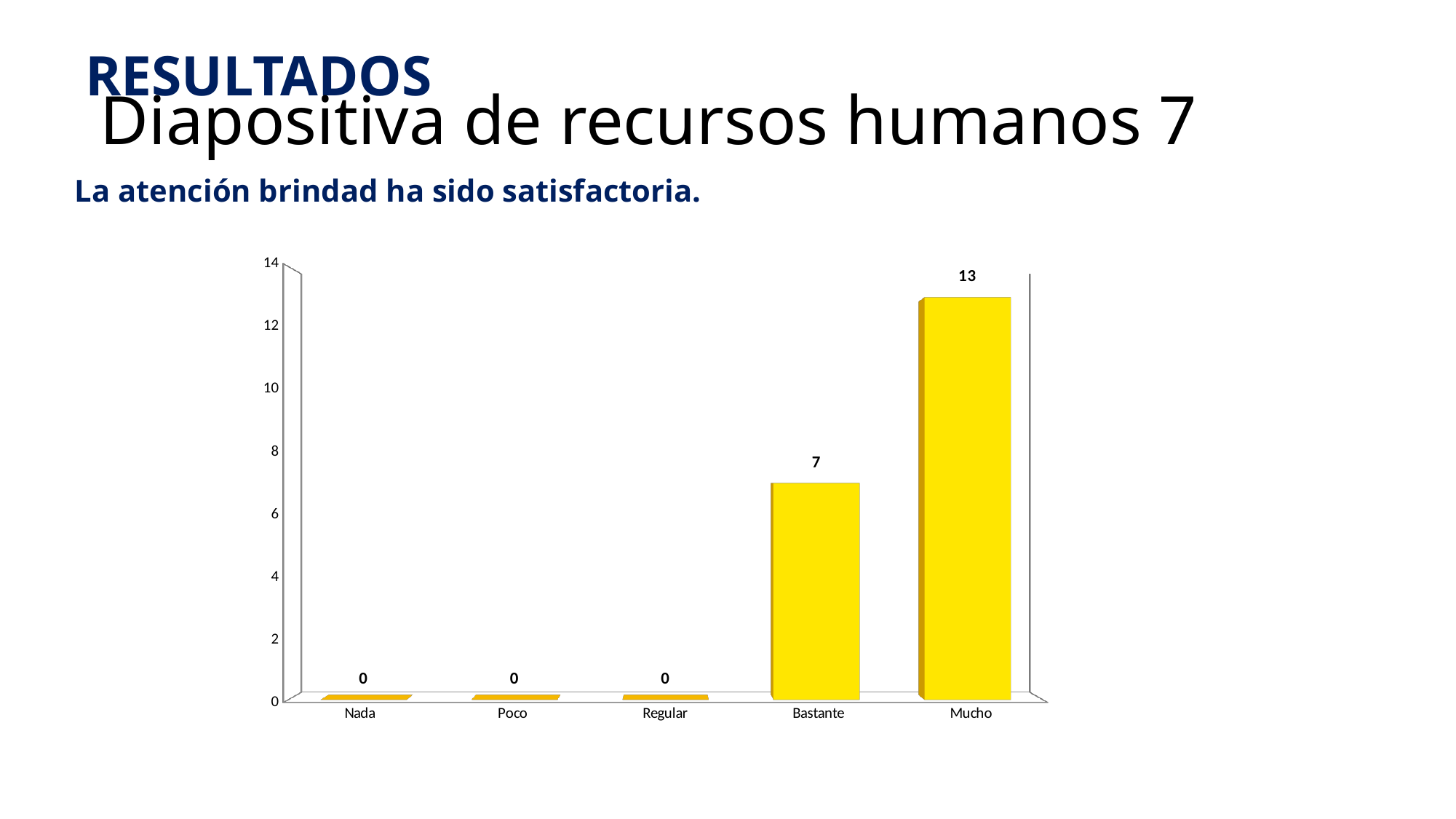
What is the value for Bastante? 7 Is the value for Bastante greater or less than 8? less What is the total of all the values shown in the chart? 20 What is the value for Regular? 0 Which category has the highest value? Mucho Which is larger, the value for Bastante or the value for Mucho? Mucho How many categories have a value of 0? 3 Is the value for Mucho greater or less than 12? greater What kind of chart is shown on the slide? Bar chart How many categories are shown on the x axis? 5 What is the difference between the values for Mucho and Bastante? 6 What is the value for Mucho? 13